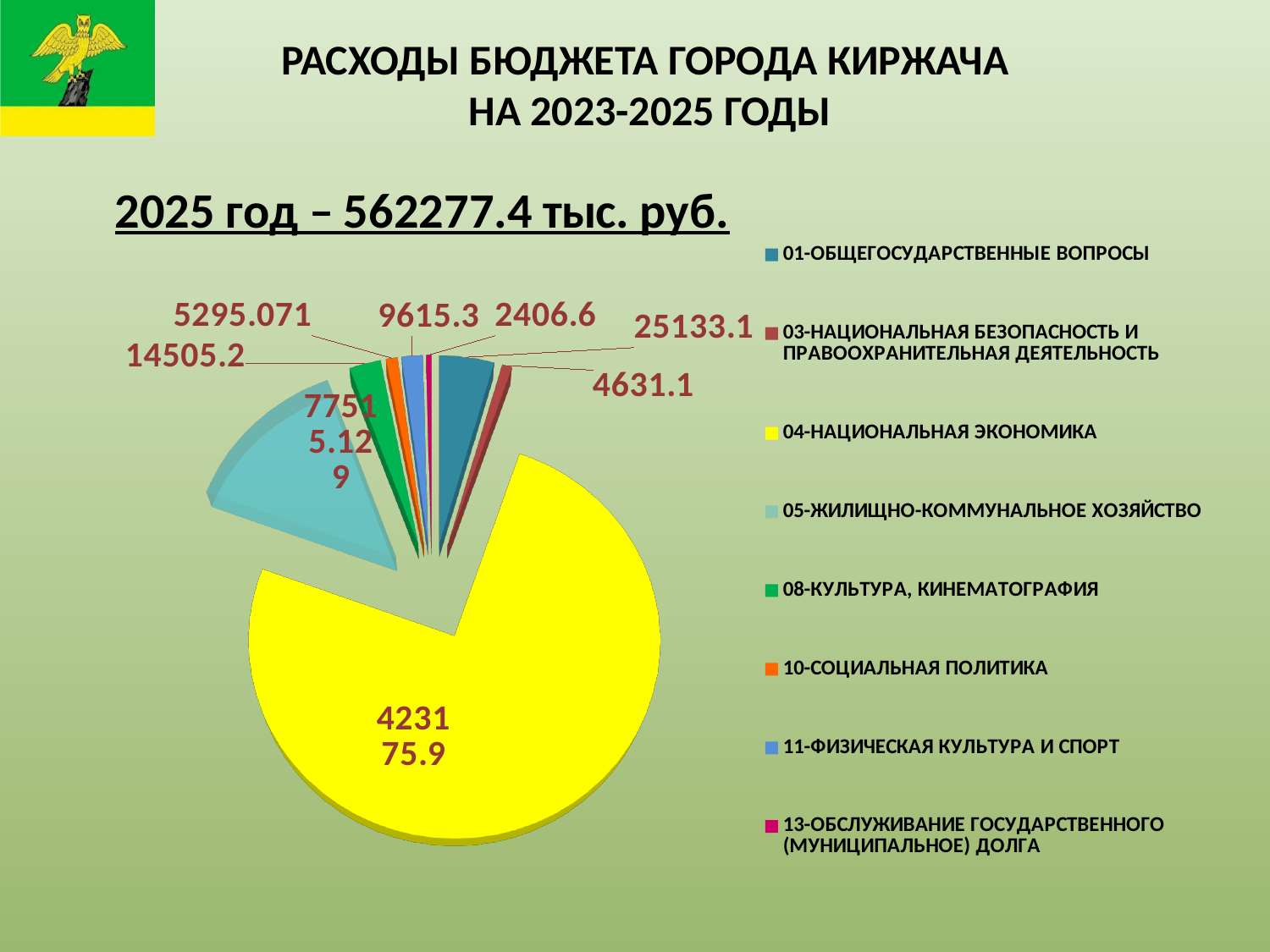
What is the value for 10-СОЦИАЛЬНАЯ ПОЛИТИКА? 5295.071 What is the value for 08-КУЛЬТУРА, КИНЕМАТОГРАФИЯ? 14505.2 What kind of chart is shown on the slide? pie chart What is the value for 11-ФИЗИЧЕСКАЯ КУЛЬТУРА И СПОРТ? 9615.3 Which category has the smallest slice of the pie? 13-ОБСЛУЖИВАНИЕ ГОСУДАРСТВЕННОГО (МУНИЦИПАЛЬНОЕ) ДОЛГА What is the value for 03-НАЦИОНАЛЬНАЯ БЕЗОПАСНОСТЬ И ПРАВООХРАНИТЕЛЬНАЯ ДЕЯТЕЛЬНОСТЬ? 4631.1 What is the value for 01-ОБЩЕГОСУДАРСТВЕННЫЕ ВОПРОСЫ? 25133.1 What is the value for 13-ОБСЛУЖИВАНИЕ ГОСУДАРСТВЕННОГО (МУНИЦИПАЛЬНОЕ) ДОЛГА? 2406.6 What colour is the slice for 04-НАЦИОНАЛЬНАЯ ЭКОНОМИКА? yellow Which category has the largest slice of the pie? 04-НАЦИОНАЛЬНАЯ ЭКОНОМИКА How many slices does the pie chart have? 8 What is the difference between the values for 01-ОБЩЕГОСУДАРСТВЕННЫЕ ВОПРОСЫ and 03-НАЦИОНАЛЬНАЯ БЕЗОПАСНОСТЬ И ПРАВООХРАНИТЕЛЬНАЯ ДЕЯТЕЛЬНОСТЬ? 20502